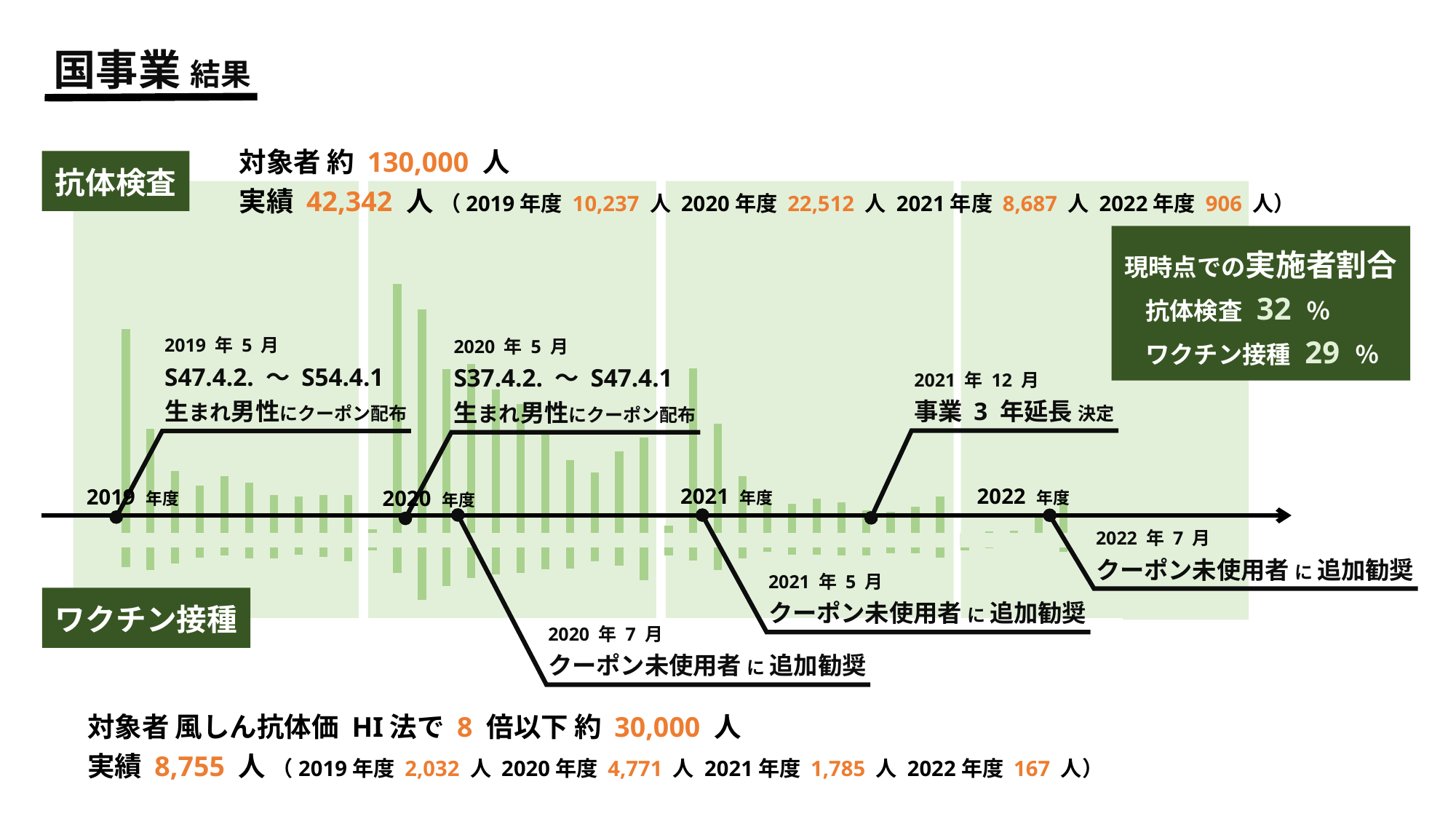
What is the total number of vaccinations (ワクチン接種 実績)? 8,755 人 Which is larger: vaccinations in 2020年度 or in 2021年度? 2020年度 What is the approximate number of target persons (対象者) for the antibody test? 約 130,000 人 What is the difference between the antibody test counts for 2020年度 and 2019年度? 12,275 人 How many people received the antibody test in fiscal year 2020 (2020年度)? 22,512 人 Which fiscal year had the highest number of antibody tests? 2020年度 How many fiscal years (年度) are marked along the timeline axis? 4 Which fiscal year had the lowest number of vaccinations (ワクチン接種)? 2022年度 What kind of chart is used to show the monthly figures along the timeline? bar chart What is the total number of people who received the antibody test (抗体検査 実績)? 42,342 人 What is the current implementation rate (実施者割合) for antibody testing? 32 % Do the antibody test bars rise or fall from fiscal year 2020 to fiscal year 2022? fall